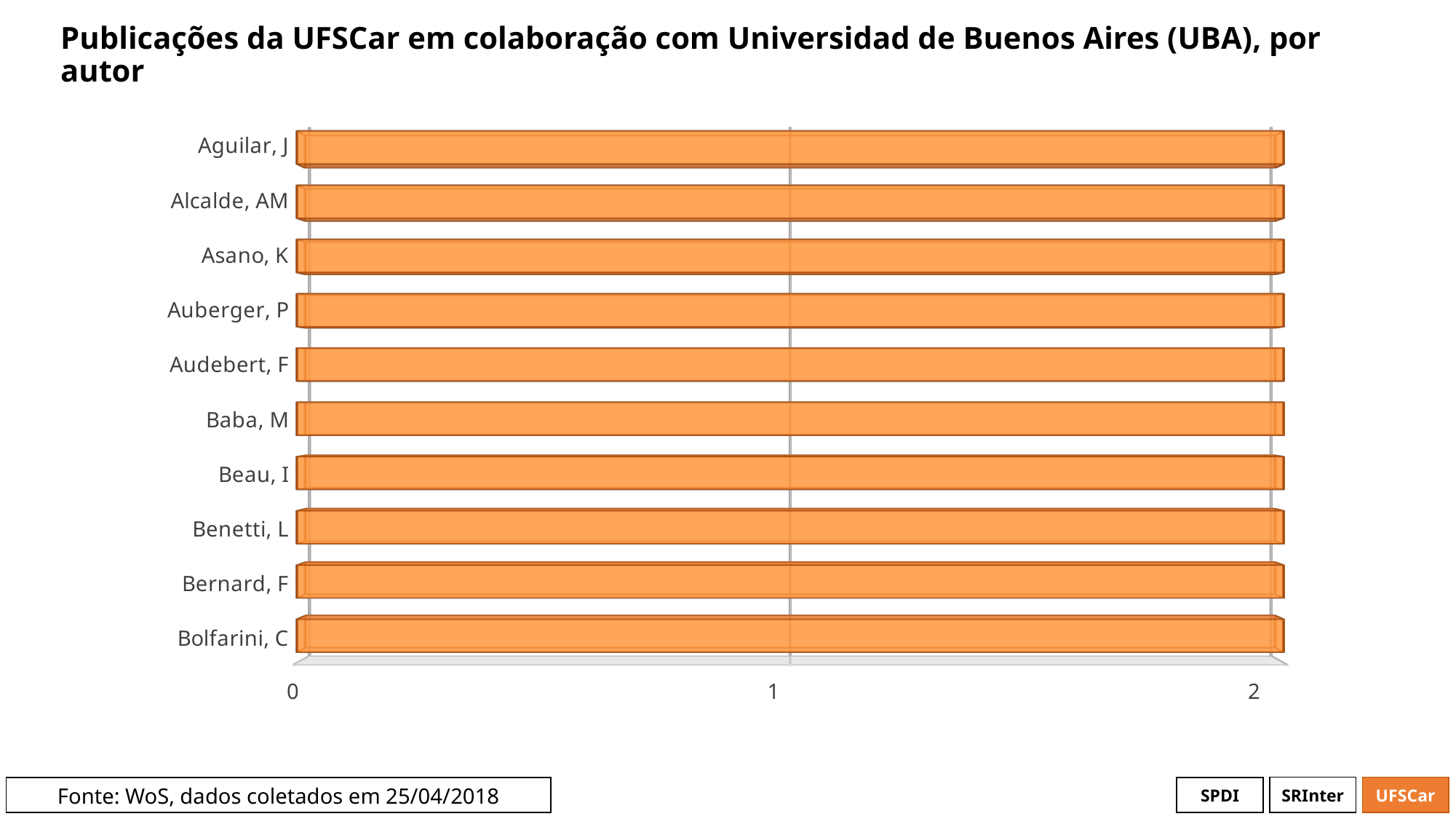
How many authors are listed on the chart? 10 Which author is listed first (at the top) of the chart? Aguilar, J Do the bars differ in length across the authors, or are they all the same? all the same What is the title of the chart? Publicações da UFSCar em colaboração com Universidad de Buenos Aires (UBA), por autor What kind of chart is shown on the slide? bar chart What is the value for Baba, M? 2 Is the value for Bernard, F greater or less than 1? greater What is the highest value shown on the horizontal axis? 2 Is the value for Asano, K greater or less than 1? greater What is the difference between the values for Alcalde, AM and Benetti, L? 0 What is the value for Bolfarini, C? 2 What is the value for Aguilar, J? 2